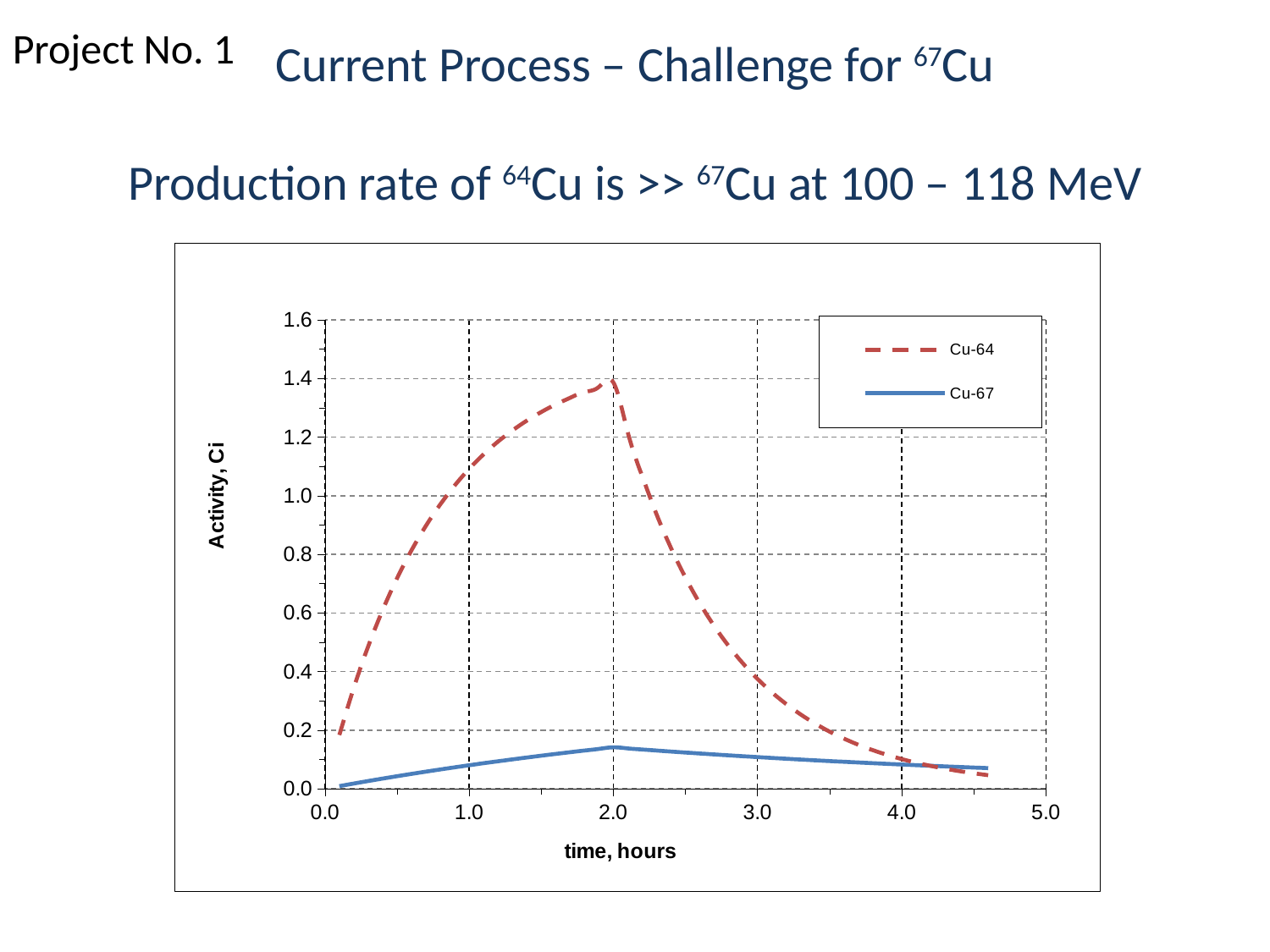
What is the label of the chart's vertical axis? Activity, Ci Is the Cu-64 activity at 1.0 hours greater or less than 0.8 Ci? greater Does the Cu-67 activity rise or fall between 0.0 and 2.0 hours? rise What kind of chart is shown on the slide? line chart Is the peak value of the Cu-67 series greater or less than 0.2 Ci? less At 2.0 hours, which series has the larger activity, Cu-64 or Cu-67? Cu-64 Does the Cu-64 activity rise or fall between 2.0 and 4.0 hours? fall Which series reaches the higher peak activity, Cu-64 or Cu-67? Cu-64 Is the Cu-64 activity at 3.0 hours greater or less than 0.6 Ci? less How many series does the chart's legend list? 2 What are the two series named in the chart's legend? Cu-64 and Cu-67